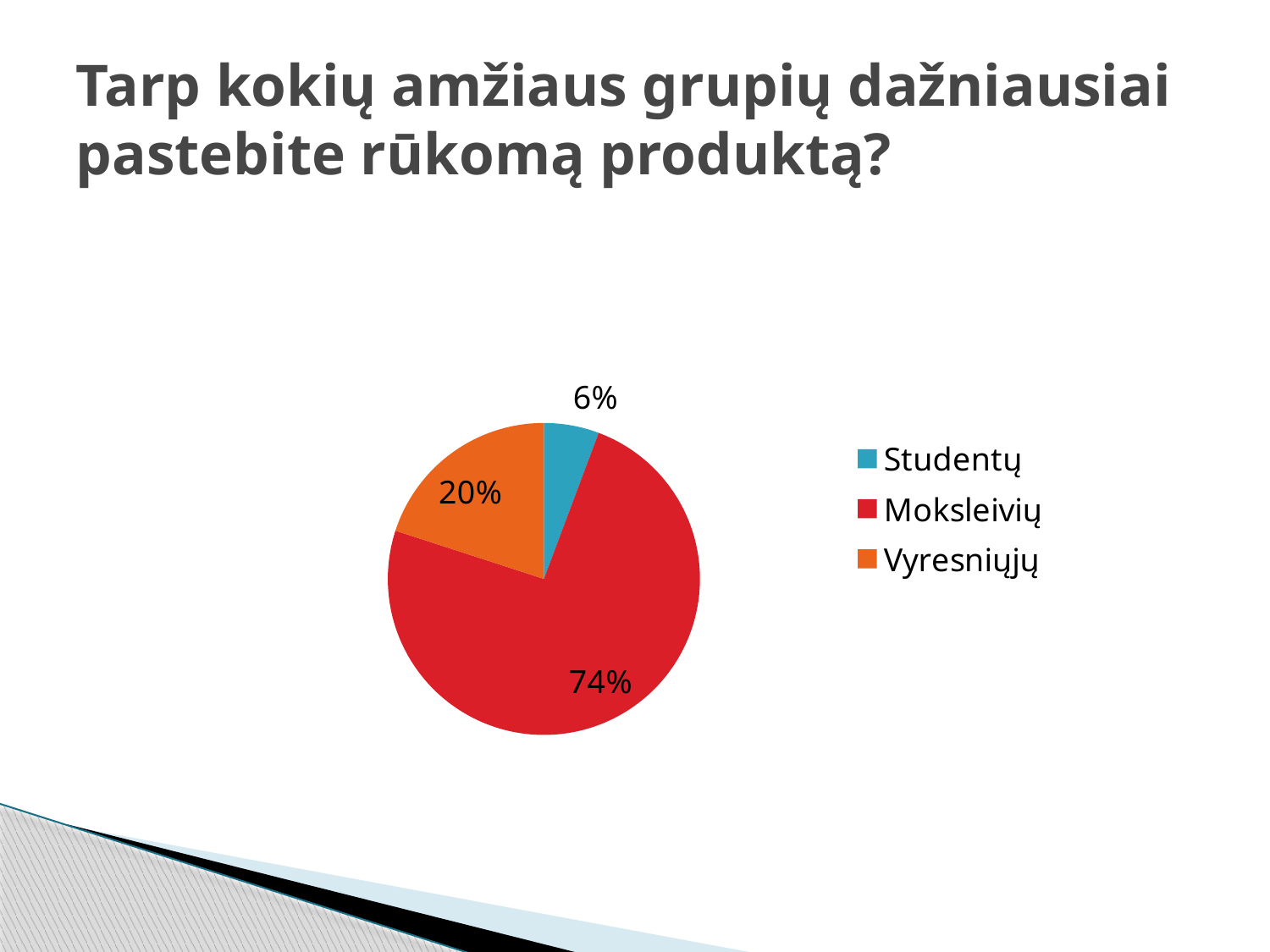
What kind of chart is shown on the slide? pie chart What share of the pie does Studentų have? 6% Which category has the largest slice of the pie? Moksleivių What is the difference in percentage points between Vyresniųjų and Studentų? 14 How many categories does the pie chart have? 3 How many entries does the legend list? 3 What share of the pie does Moksleivių have? 74% Which is larger, the slice for Vyresniųjų or the slice for Studentų? Vyresniųjų What share of the pie does Vyresniųjų have? 20% What colour is the slice for Moksleivių? red Which category has the smallest slice of the pie? Studentų What is the difference in percentage points between Moksleivių and Vyresniųjų? 54